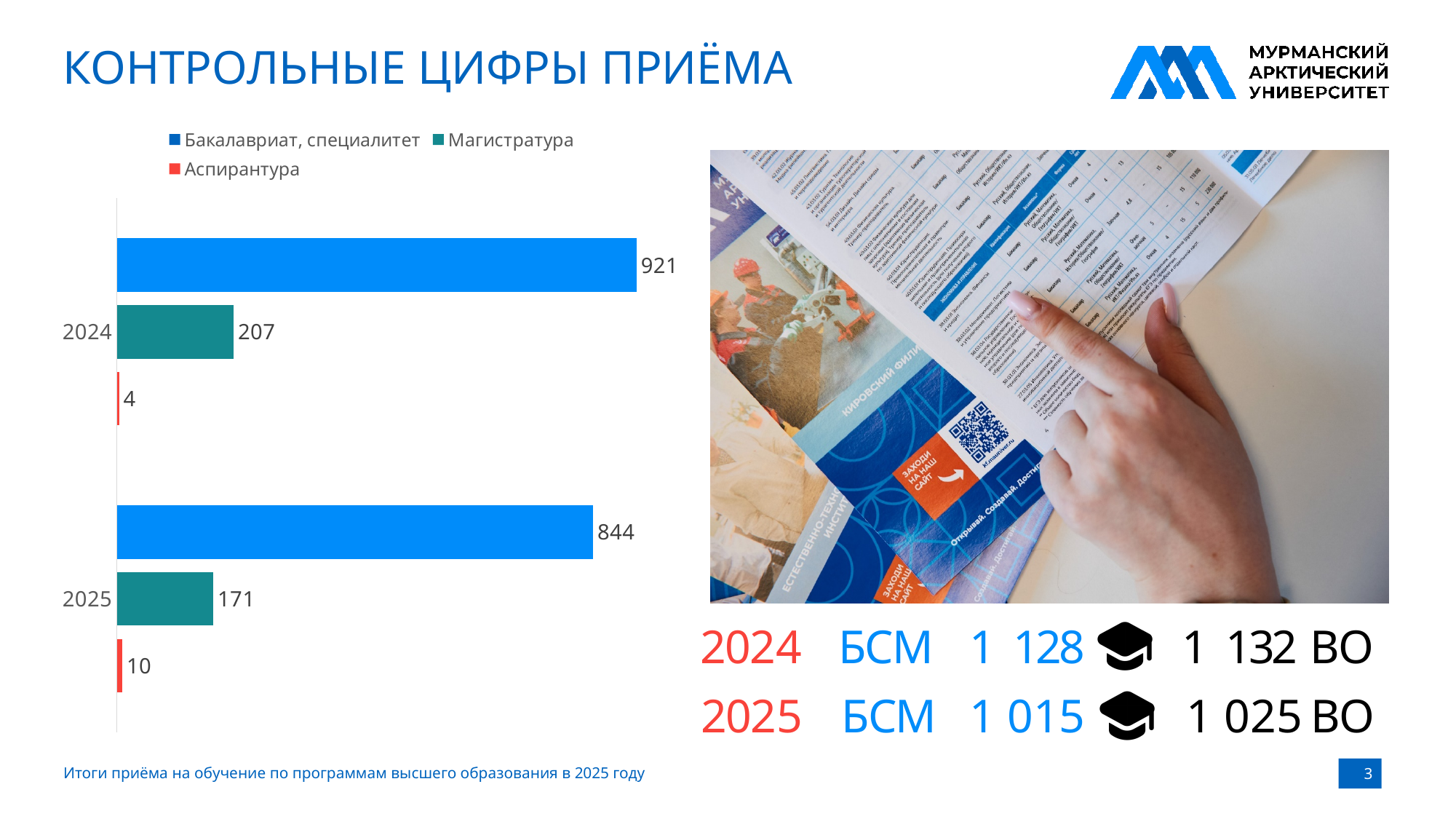
Which is larger: Аспирантура in 2024 or Аспирантура in 2025? 2025 Which series has the highest value in 2025? Бакалавриат, специалитет What is the difference between the Магистратура values for 2024 and 2025? 36 What is the value for Магистратура in 2025? 171 What is the value for Аспирантура in 2024? 4 What is the difference between the Бакалавриат, специалитет values for 2024 and 2025? 77 What is the value for Аспирантура in 2025? 10 How many series does the legend list? 3 What kind of chart is shown on the slide? Bar chart Which series has the lowest value in 2024? Аспирантура What is the value for Бакалавриат, специалитет in 2024? 921 How many year categories are shown on the chart? 2